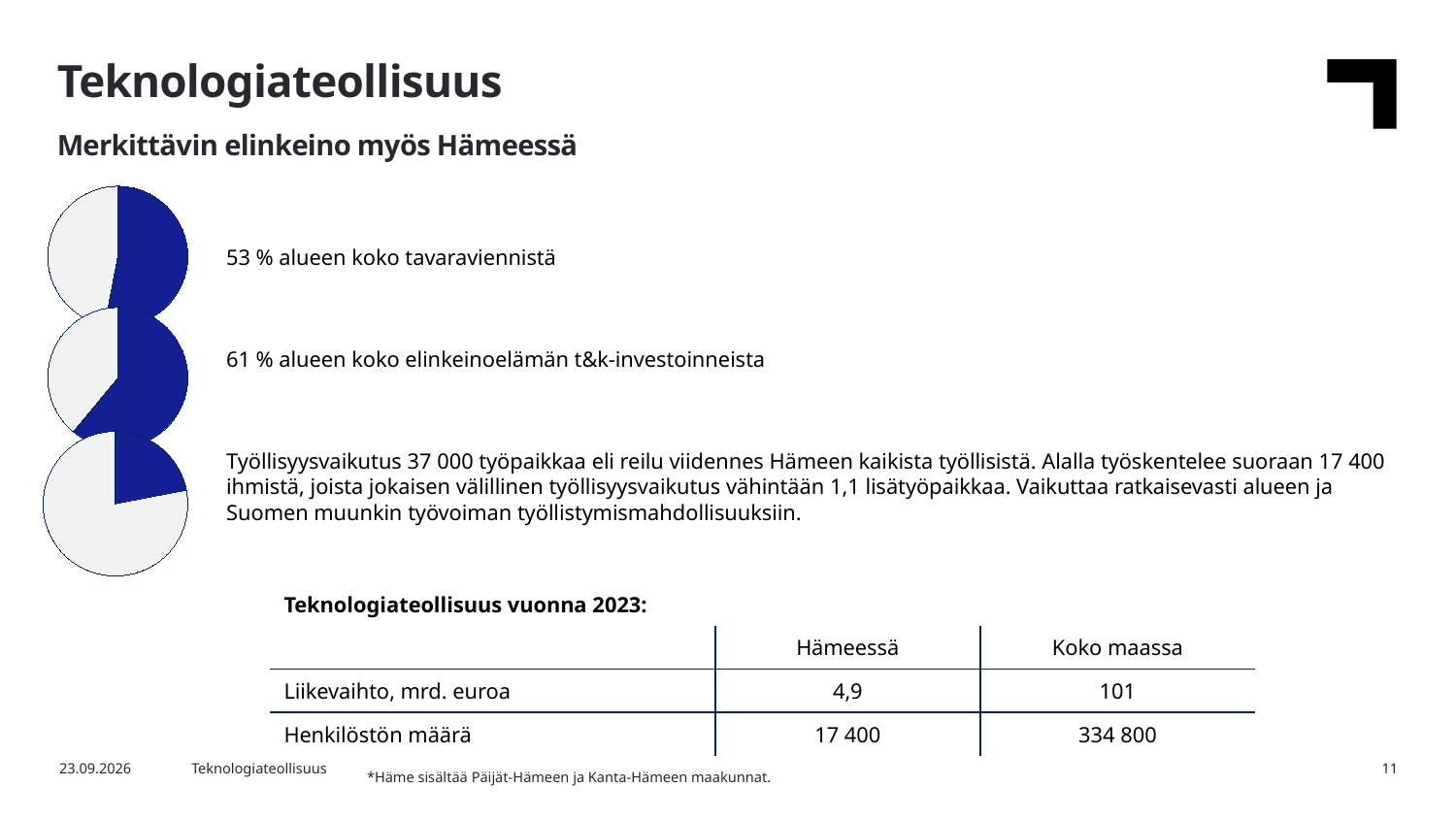
Which of the three pie charts has the largest dark blue share? The middle one (t&k-investoinnit, 61 %) In the top pie chart, what share does the dark blue slice represent (alueen koko tavaraviennistä)? 53 % What colour is used for the highlighted slice in the pie charts? Dark blue What is the difference in percentage points between the dark blue shares of the middle pie chart (61 %) and the top pie chart (53 %)? 8 percentage points What kind of charts are shown on the left side of the slide? Pie charts How many pie charts are shown on the slide? 3 Which pie chart has the larger dark blue slice, the top one (tavaravienti) or the middle one (t&k-investoinnit)? The middle one (t&k-investoinnit, 61 %) How many slices does each pie chart have? 2 In the middle pie chart, what share does the dark blue slice represent (alueen koko elinkeinoelämän t&k-investoinneista)? 61 % In the bottom pie chart, is the dark blue slice greater or less than 50 %? less Which of the three pie charts has the smallest dark blue share? The bottom one (työllisyysvaikutus) In the middle pie chart, is the dark blue slice greater or less than 50 %? greater